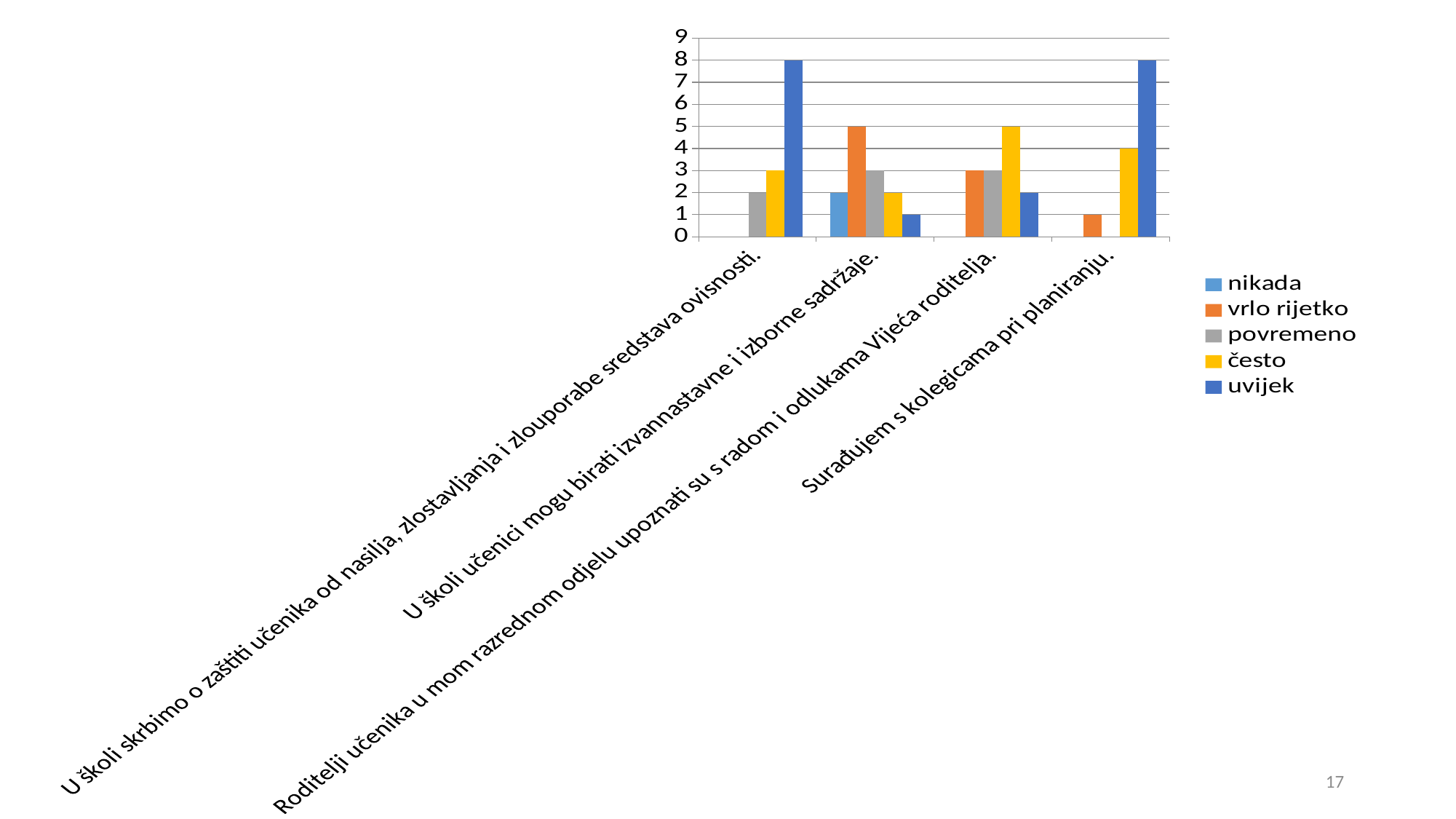
What is the value of "vrlo rijetko" for "U školi učenici mogu birati izvannastavne i izborne sadržaje."? 5 Which series has the lowest non-zero value for "Surađujem s kolegicama pri planiranju."? vrlo rijetko What is the value of "često" for "Roditelji učenika u mom razrednom odjelu upoznati su s radom i odlukama Vijeća roditelja."? 5 Which legend entry is shown in yellow? često What is the difference between "uvijek" and "često" for "Surađujem s kolegicama pri planiranju."? 4 Which is larger for "U školi učenici mogu birati izvannastavne i izborne sadržaje.": "povremeno" or "uvijek"? povremeno What is the value of "uvijek" for "U školi skrbimo o zaštiti učenika od nasilja, zlostavljanja i zlouporabe sredstava ovisnosti."? 8 How many categories are shown on the x axis? 4 What type of chart is shown on the slide? bar chart Which series has the highest value for "U školi učenici mogu birati izvannastavne i izborne sadržaje."? vrlo rijetko How many series does the legend list? 5 What is the value of "često" for "Surađujem s kolegicama pri planiranju."? 4